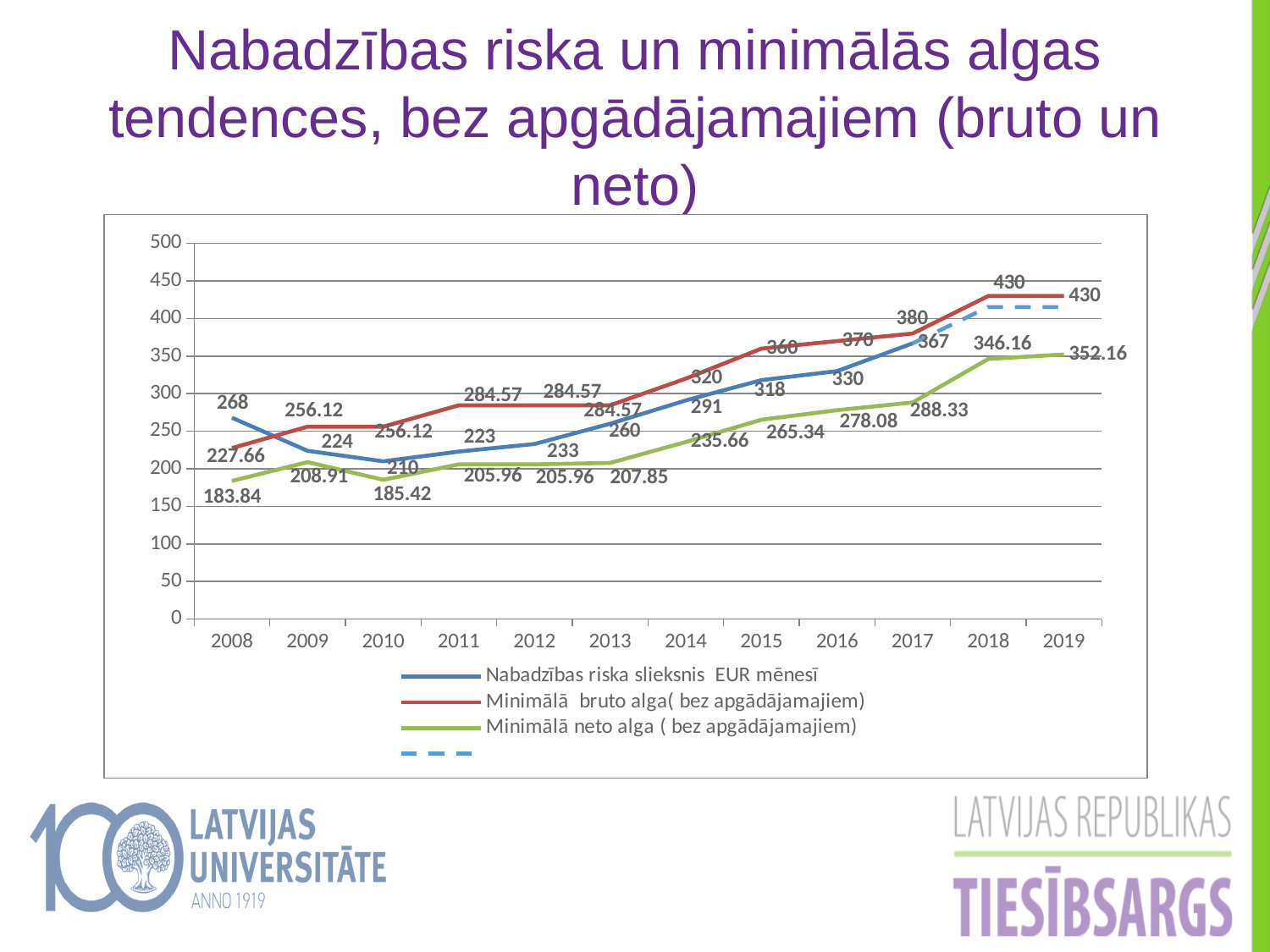
What is the value of Minimālā bruto alga (bez apgādājamajiem) in 2018? 430 In which year is Minimālā neto alga (bez apgādājamajiem) highest? 2019 What is the value of Minimālā neto alga (bez apgādājamajiem) in 2019? 352.16 What is the value of Minimālā neto alga (bez apgādājamajiem) in 2008? 183.84 In 2008, which is larger: Nabadzības riska slieksnis EUR mēnesī or Minimālā bruto alga (bez apgādājamajiem)? Nabadzības riska slieksnis EUR mēnesī In which year is the labelled Nabadzības riska slieksnis EUR mēnesī value lowest? 2010 How many years are shown on the x axis? 12 By how much did Minimālā bruto alga (bez apgādājamajiem) increase from 2017 to 2018? 50 Is the value of Minimālā bruto alga (bez apgādājamajiem) in 2014 greater or less than 300? greater What is the Nabadzības riska slieksnis EUR mēnesī value in 2010? 210 What kind of chart is shown on the slide? Line chart What is the difference between Minimālā bruto alga and Minimālā neto alga in 2019? 77.84